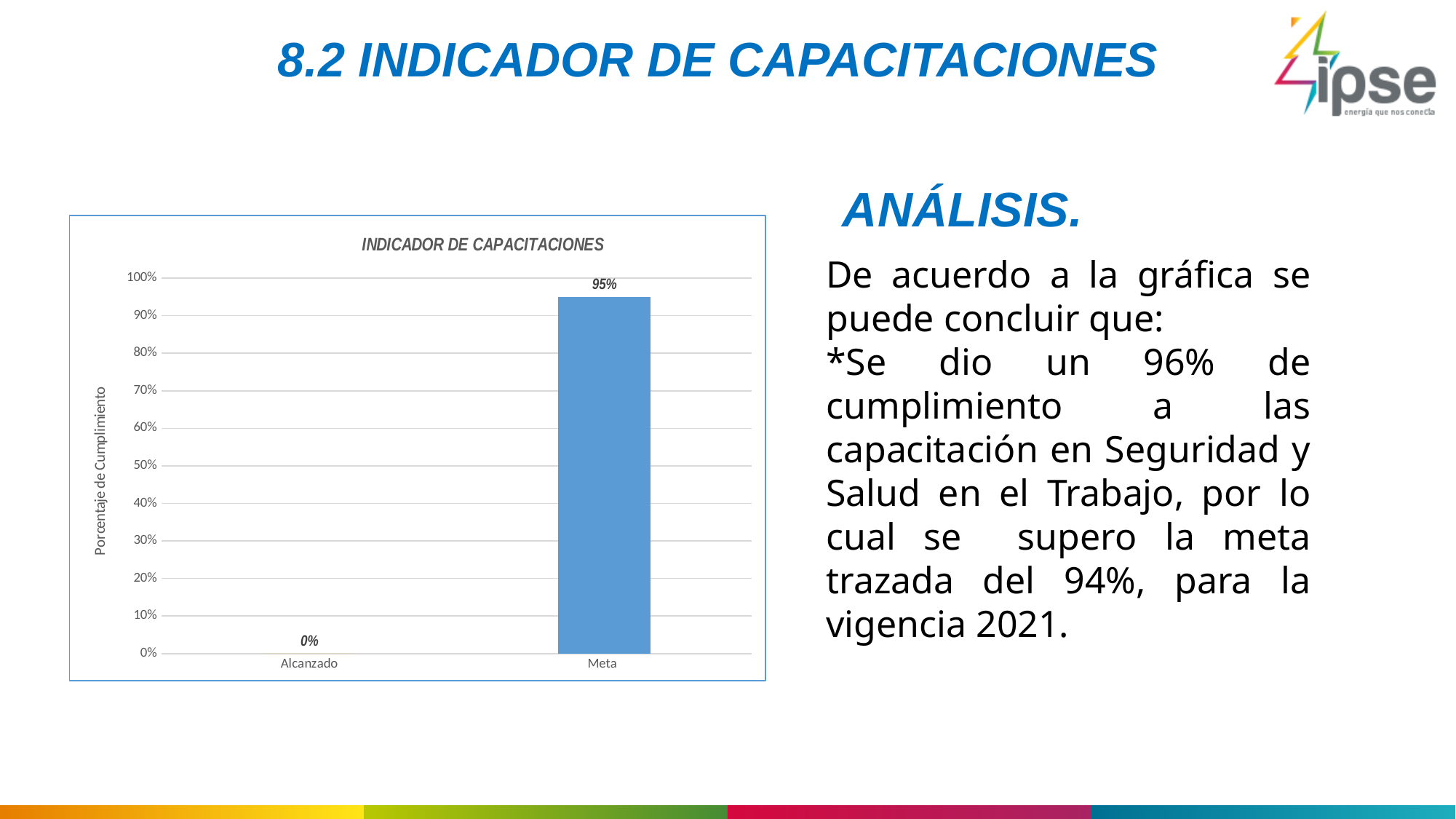
Do the values rise or fall from Alcanzado to Meta? rise What is the title of the chart? INDICADOR DE CAPACITACIONES Is the value for Meta greater or less than 90%? greater Which is larger, the value for Alcanzado or the value for Meta? Meta Which category has the lowest value? Alcanzado Which category has the highest value? Meta What is the label of the vertical axis? Porcentaje de Cumplimiento How many categories are shown on the x axis? 2 What is the value for Meta? 95% What is the difference between the values for Meta and Alcanzado? 95% What kind of chart is shown? bar chart What is the value for Alcanzado? 0%